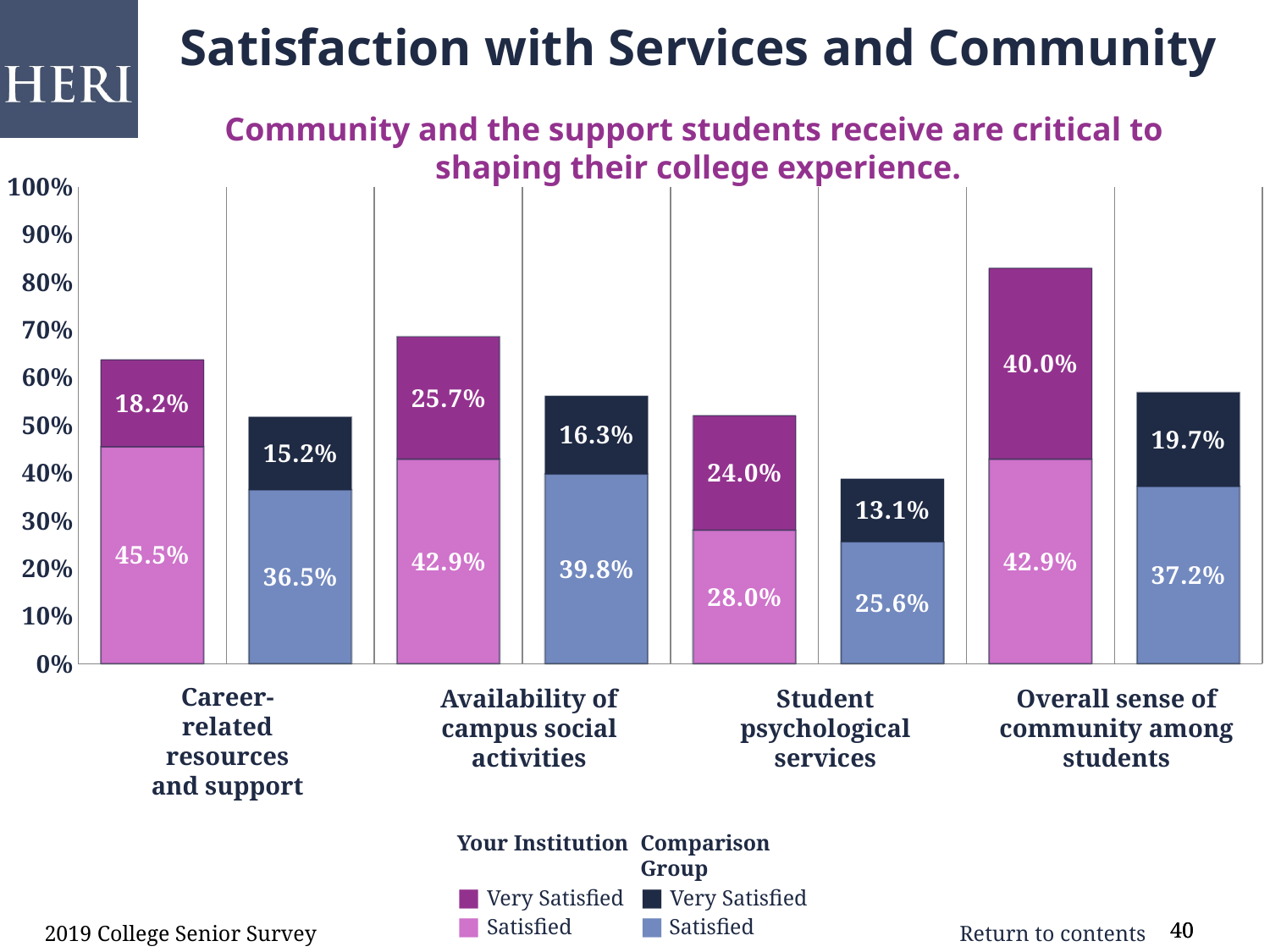
How many entries does the chart legend list? 4 Is the total stacked bar for the Comparison Group on Overall sense of community among students greater or less than 50%? greater What is the difference between the Very Satisfied percentages for Your Institution and the Comparison Group on Availability of campus social activities? 9.4% Which category has the highest Very Satisfied percentage for Your Institution? Overall sense of community among students What is the total percentage (Satisfied plus Very Satisfied) for Your Institution on Overall sense of community among students? 82.9% For Career-related resources and support, which group has the larger Satisfied percentage, Your Institution or the Comparison Group? Your Institution What percentage of the Comparison Group were Satisfied with Student psychological services? 25.6% Which category has the lowest Very Satisfied percentage for the Comparison Group? Student psychological services What percentage of Your Institution students were Very Satisfied with Overall sense of community among students? 40.0% What percentage of Your Institution students were Satisfied with Career-related resources and support? 45.5% What is the total percentage (Satisfied plus Very Satisfied) for the Comparison Group on Student psychological services? 38.7% How many categories are shown on the x axis of the chart? 4